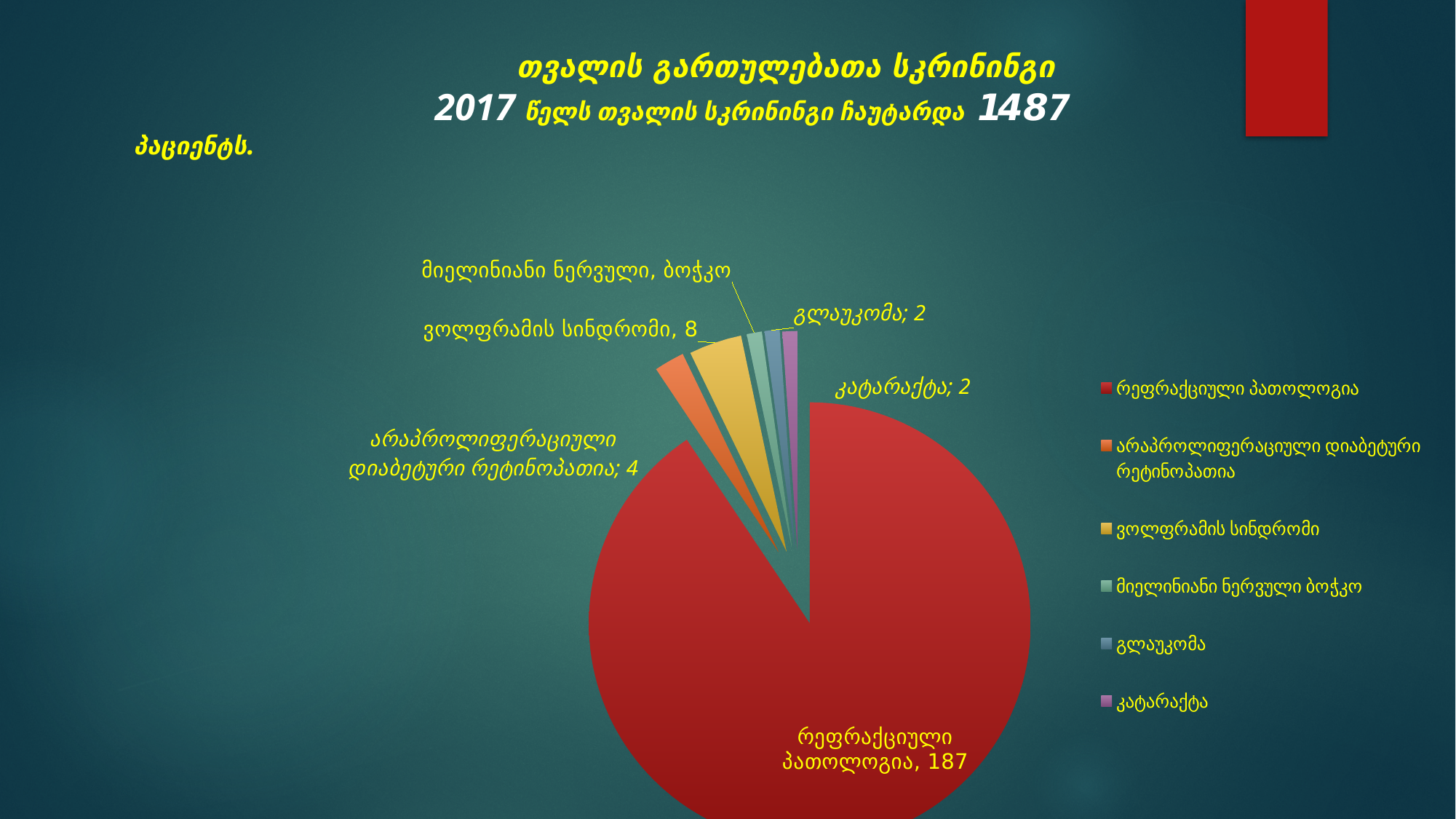
What is the value for გლაუკომა? 2 What colour is the slice for რეფრაქციული პათოლოგია? Red What is the value for არაპროლიფერაციული დიაბეტური რეტინოპათია? 4 What type of chart is shown on the slide? Pie chart What is the value for კატარაქტა? 2 What is the difference between the values for ვოლფრამის სინდრომი and არაპროლიფერაციული დიაბეტური რეტინოპათია? 4 What is the value for ვოლფრამის სინდრომი? 8 Which is larger, the value for ვოლფრამის სინდრომი or the value for გლაუკომა? ვოლფრამის სინდრომი How many entries does the legend list? 6 What is the difference between the values for რეფრაქციული პათოლოგია and ვოლფრამის სინდრომი? 179 What is the value for რეფრაქციული პათოლოგია? 187 Which category has the largest slice of the pie? რეფრაქციული პათოლოგია